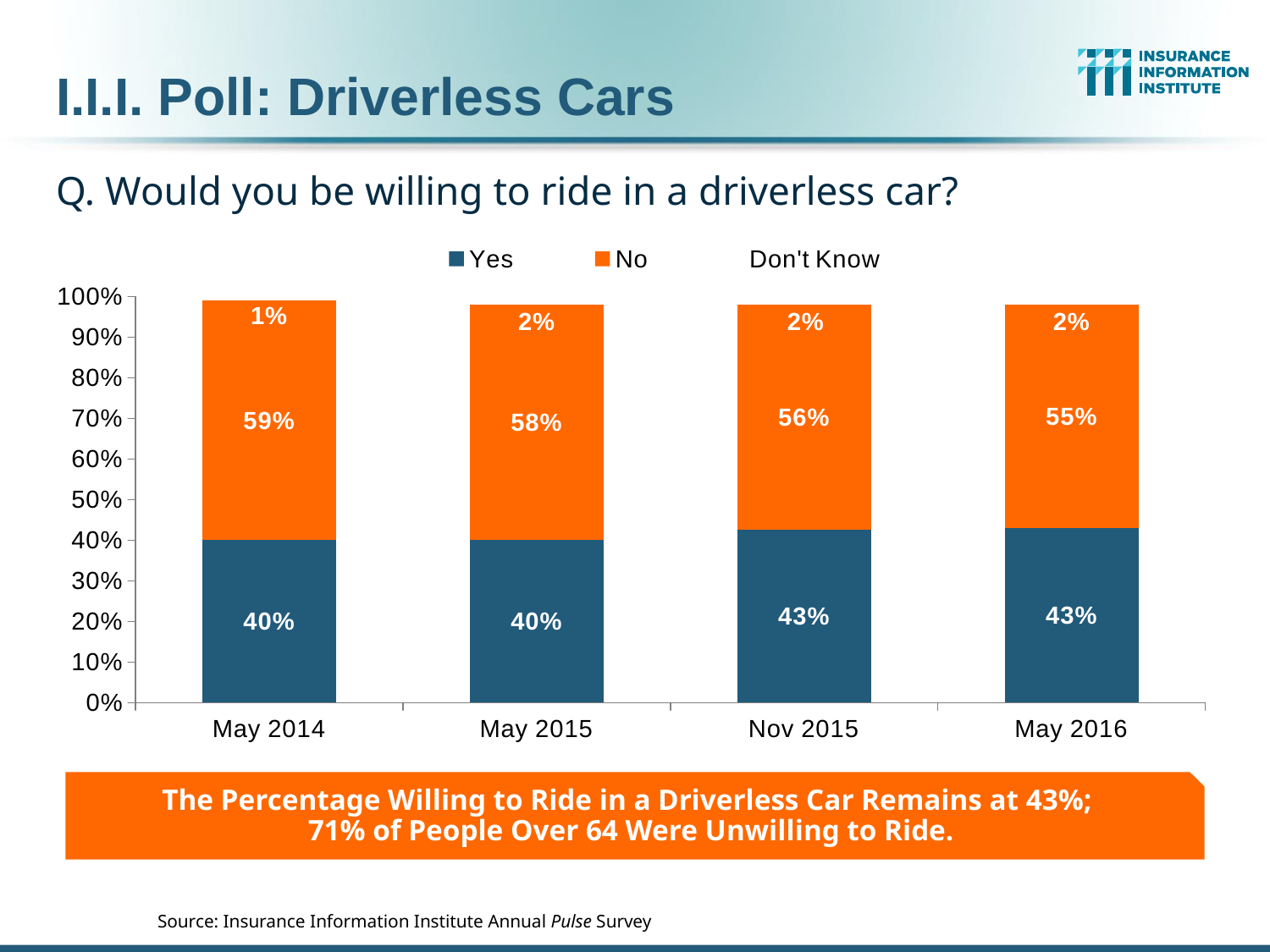
Which is larger: the Yes share in May 2015 or the Yes share in Nov 2015? Nov 2015 What is the difference between the No share in May 2014 and the No share in May 2016? 4% What percentage answered Yes in May 2016? 43% How many time periods are shown on the x axis? 4 How many series does the legend list? 3 In which period was the No share the highest? May 2014 What percentage answered Yes in Nov 2015? 43% What percentage answered No in May 2014? 59% Does the No share rise or fall from May 2014 to May 2016? Fall What kind of chart is shown on the slide? Stacked bar chart What is the Don't Know value for May 2015? 2% In which period was the No share the lowest? May 2016